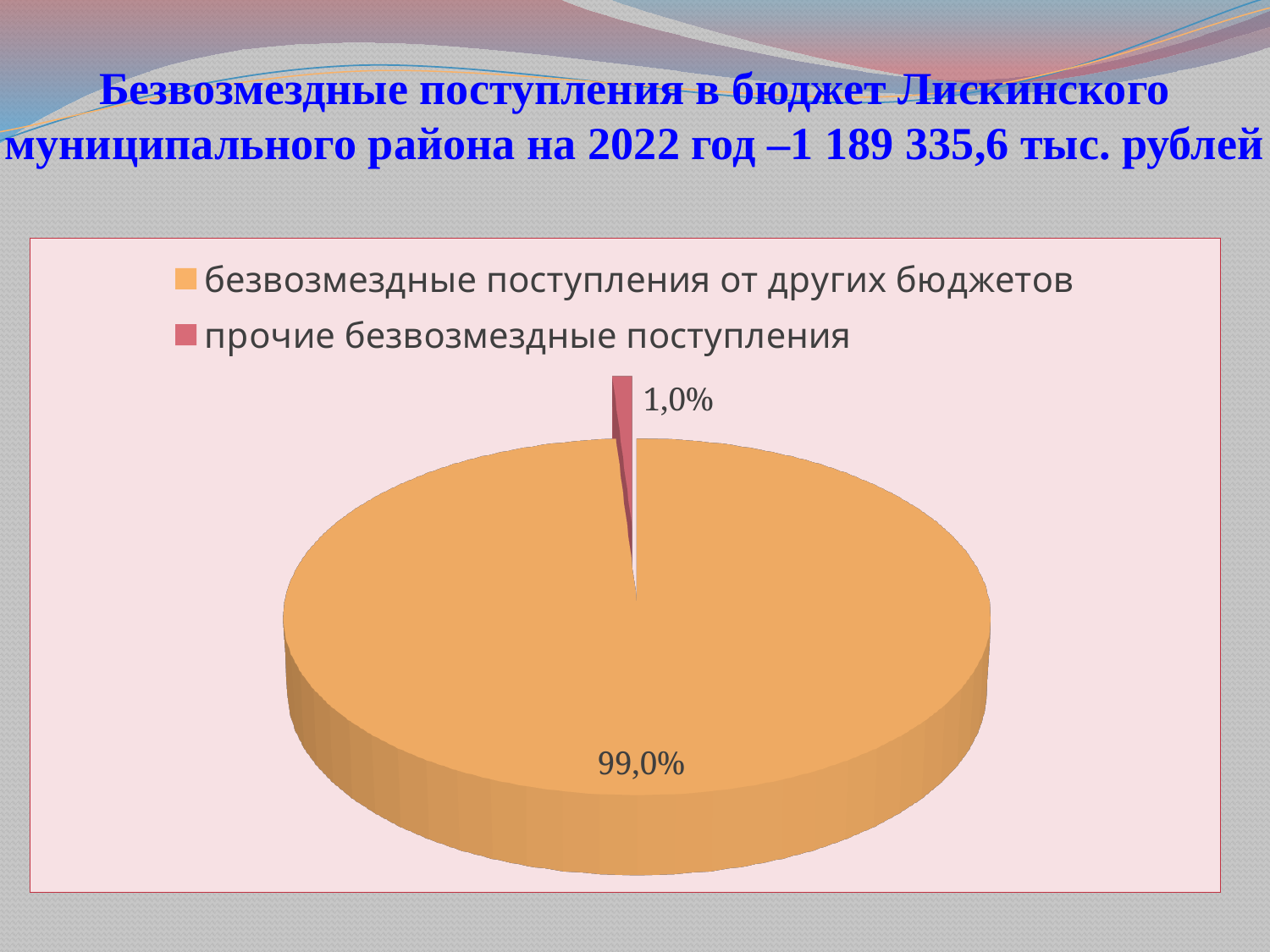
What colour is the slice for 'прочие безвозмездные поступления'? red Which category has the smallest slice of the pie? прочие безвозмездные поступления What share of the pie does 'безвозмездные поступления от других бюджетов' have? 99,0% What is the difference in percentage points between the share of 'безвозмездные поступления от других бюджетов' and 'прочие безвозмездные поступления'? 98,0% How many entries does the legend list? 2 How many slices does the pie chart have? 2 What share of the pie does 'прочие безвозмездные поступления' have? 1,0% Which is larger: the share of 'прочие безвозмездные поступления' or the share of 'безвозмездные поступления от других бюджетов'? безвозмездные поступления от других бюджетов What total amount of gratuitous receipts for 2022 is stated in the slide title? 1 189 335,6 тыс. рублей What kind of chart is shown on the slide? pie chart Which category has the largest slice of the pie? безвозмездные поступления от других бюджетов